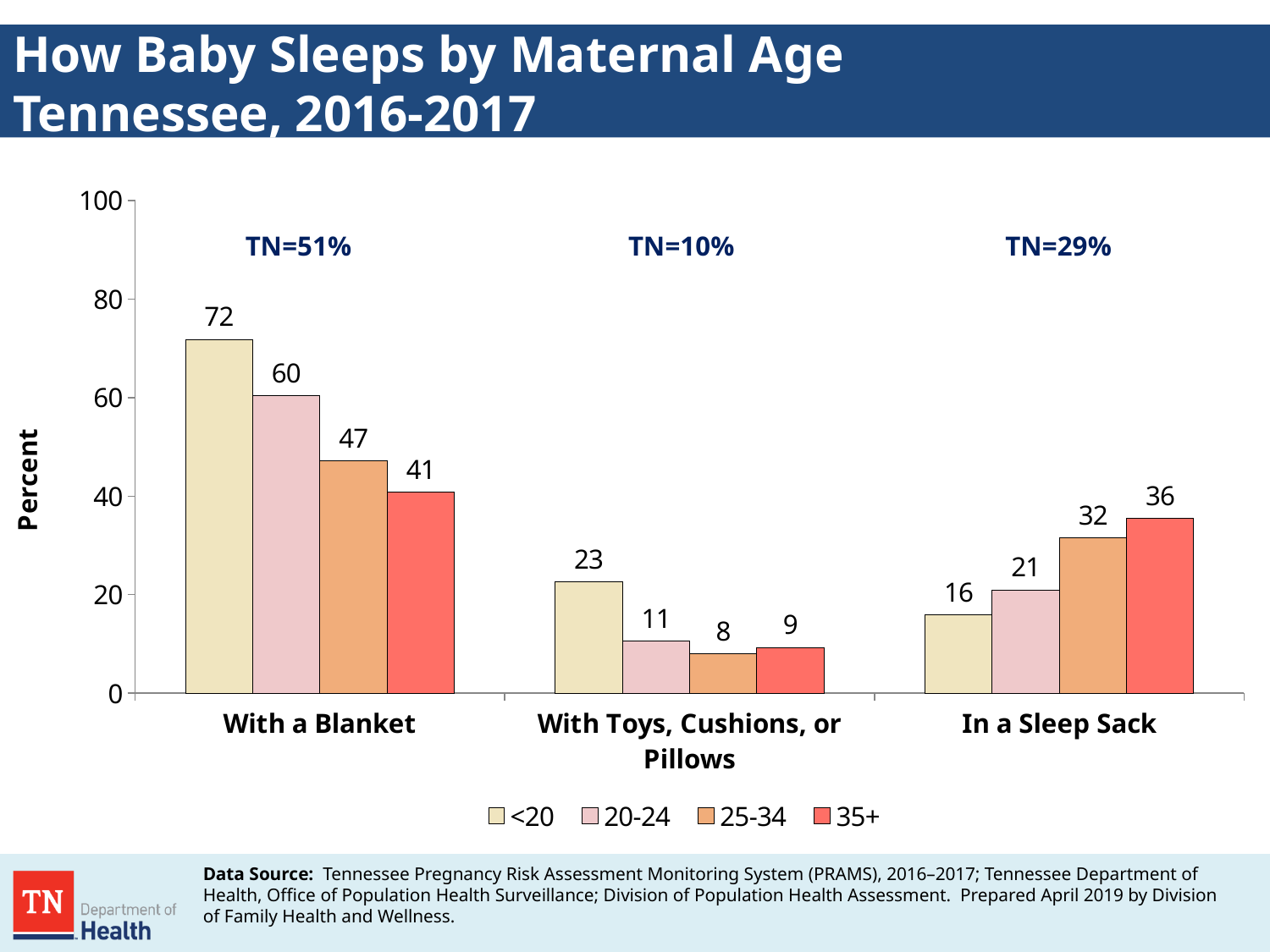
What is the value for the <20 maternal age group for 'With a Blanket'? 72 Which maternal age group has the highest value for 'With a Blanket'? <20 What is the value for the 35+ maternal age group for 'In a Sleep Sack'? 36 How many sleep categories are shown on the x axis? 3 What is the value for the 25-34 maternal age group for 'With Toys, Cushions, or Pillows'? 8 What kind of chart is shown on the slide? Bar chart What is the difference between the <20 and 35+ values for 'With a Blanket'? 31 Do the values for 'In a Sleep Sack' rise or fall as maternal age increases from <20 to 35+? Rise Which is larger for 'With Toys, Cushions, or Pillows': the value for 20-24 or the value for 35+? 20-24 What is the Tennessee overall percentage shown above the 'With Toys, Cushions, or Pillows' group? 10% How many maternal age groups does the legend list? 4 Which maternal age group has the lowest value for 'In a Sleep Sack'? <20